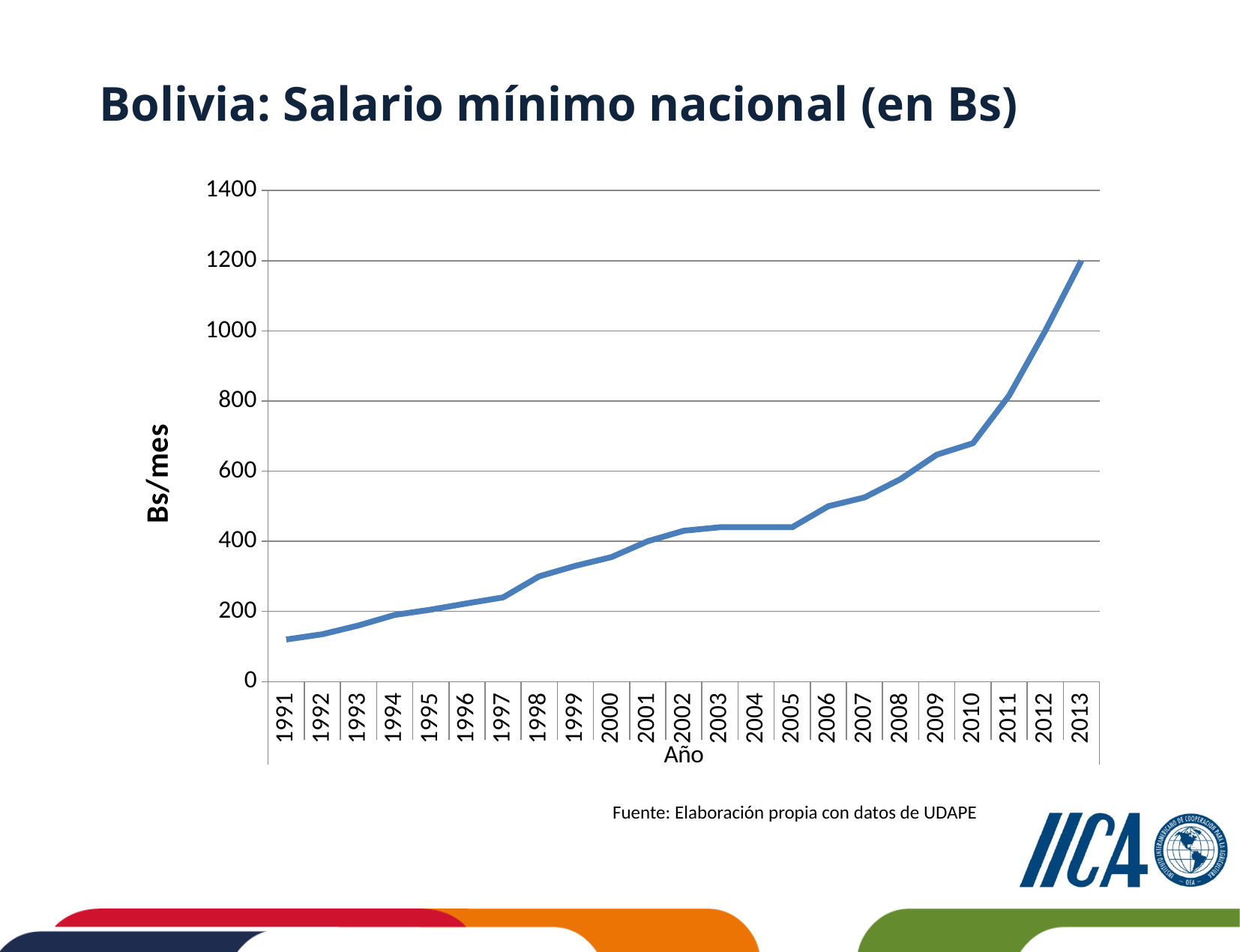
What kind of chart is shown on the slide? line chart Is the value for 2000 greater or less than 400? less Is the value for 2010 greater or less than 600? greater Is the value for 1991 greater or less than 200? less In which year is the national minimum wage lowest? 1991 Which year has a higher value, 2003 or 2008? 2008 What is the label of the vertical axis? Bs/mes What is the value for 2013? 1200 In which year is the national minimum wage highest? 2013 Does the minimum wage rise or fall from 1991 to 2013? rise How many years are plotted on the x axis? 23